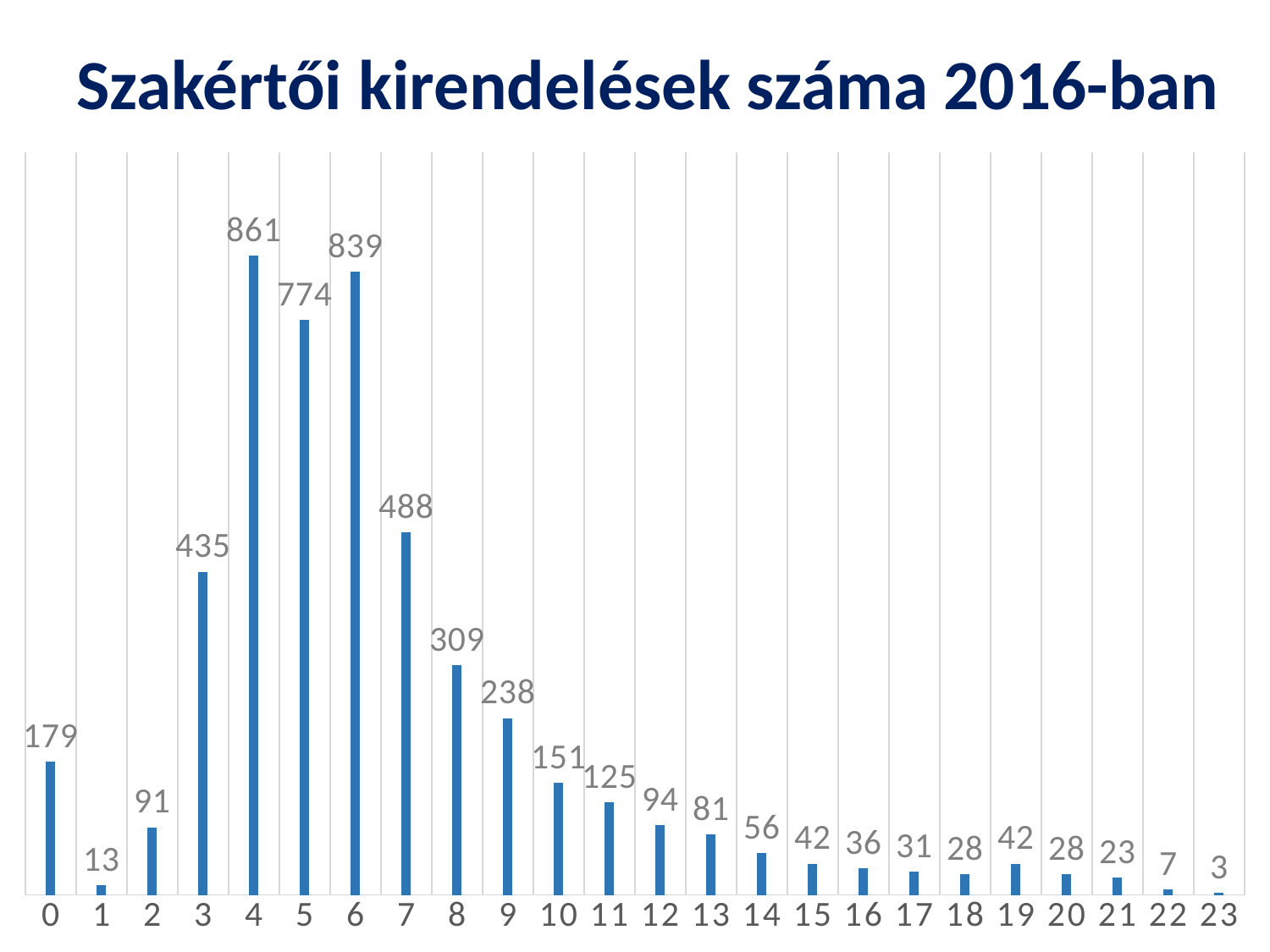
Which is larger, the value for category 3 or the value for category 7? 7 Which category has the highest value? 4 What is the difference between the values for categories 1 and 2? 78 Which category has the lowest value? 23 What is the value for category 0? 179 Do the values rise or fall along the x axis from category 6 to category 23? fall How many categories are shown on the x axis? 24 What is the value for category 8? 309 What is the difference between the values for categories 4 and 6? 22 What kind of chart is shown on the slide? bar chart What is the value for category 4? 861 What is the title of the chart? Szakértői kirendelések száma 2016-ban